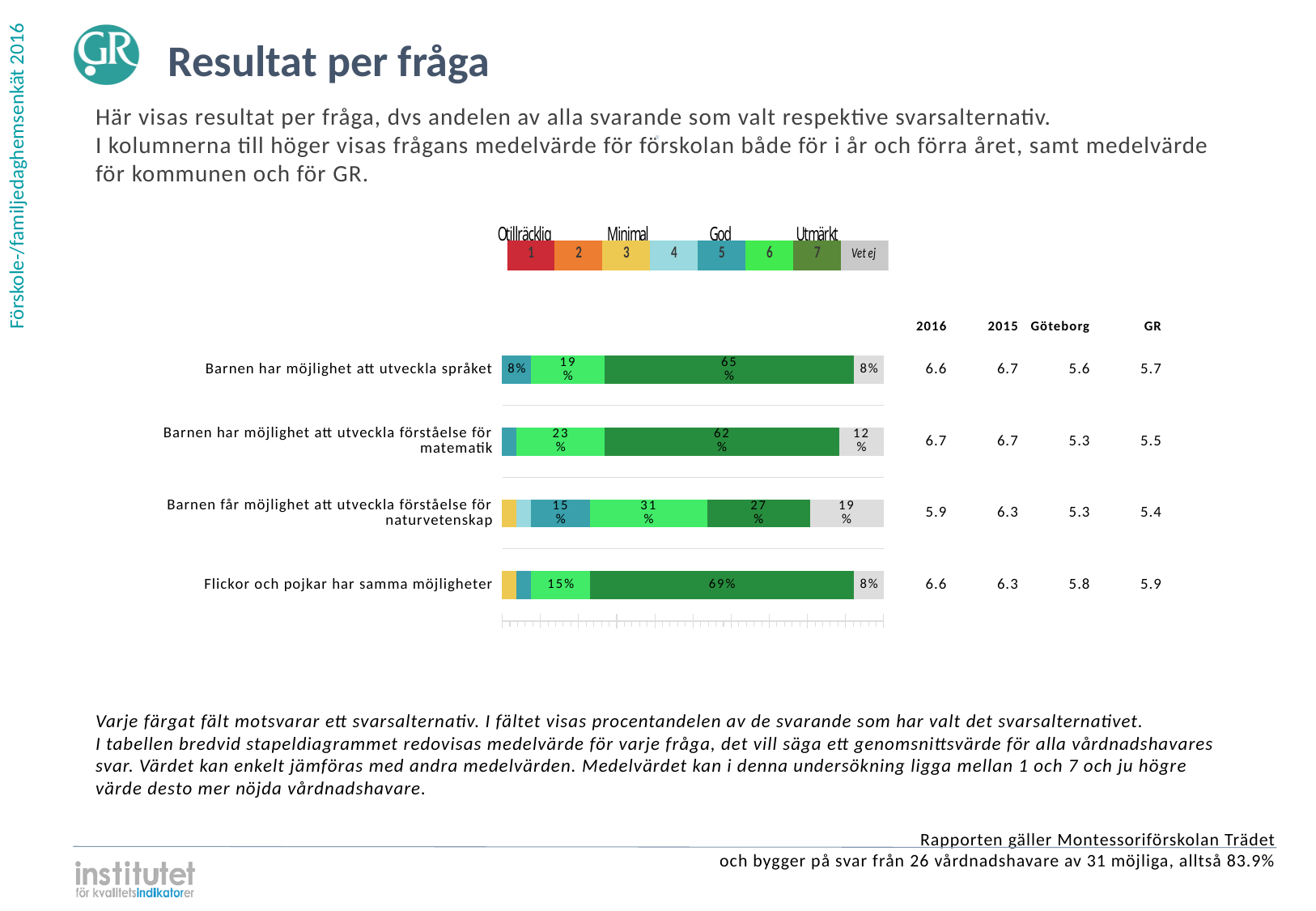
Which question has the highest share of option 7 (dark green) responses? Flickor och pojkar har samma möjligheter What label does the legend give to the grey answer option at the far right? Vet ej What is the 'Vet ej' share for 'Barnen får möjlighet att utveckla förståelse för naturvetenskap'? 19% How many answer options does the legend above the chart list? 8 What percentage chose option 6 (light green) for 'Barnen har möjlighet att utveckla förståelse för matematik'? 23% What is the difference between the option 7 share for 'Flickor och pojkar har samma möjligheter' and for 'Barnen har möjlighet att utveckla språket'? 4% Which question has the lowest share of option 7 (dark green) responses? Barnen får möjlighet att utveckla förståelse för naturvetenskap What percentage of respondents chose option 7 (dark green) for 'Barnen har möjlighet att utveckla språket'? 65% Which is larger: the option 6 share for 'Barnen får möjlighet att utveckla förståelse för naturvetenskap' or for 'Barnen har möjlighet att utveckla förståelse för matematik'? Barnen får möjlighet att utveckla förståelse för naturvetenskap How many questions (categories) are plotted in the bar chart? 4 What percentage chose option 7 (dark green) for 'Flickor och pojkar har samma möjligheter'? 69% What kind of chart is shown on the slide? Stacked bar chart